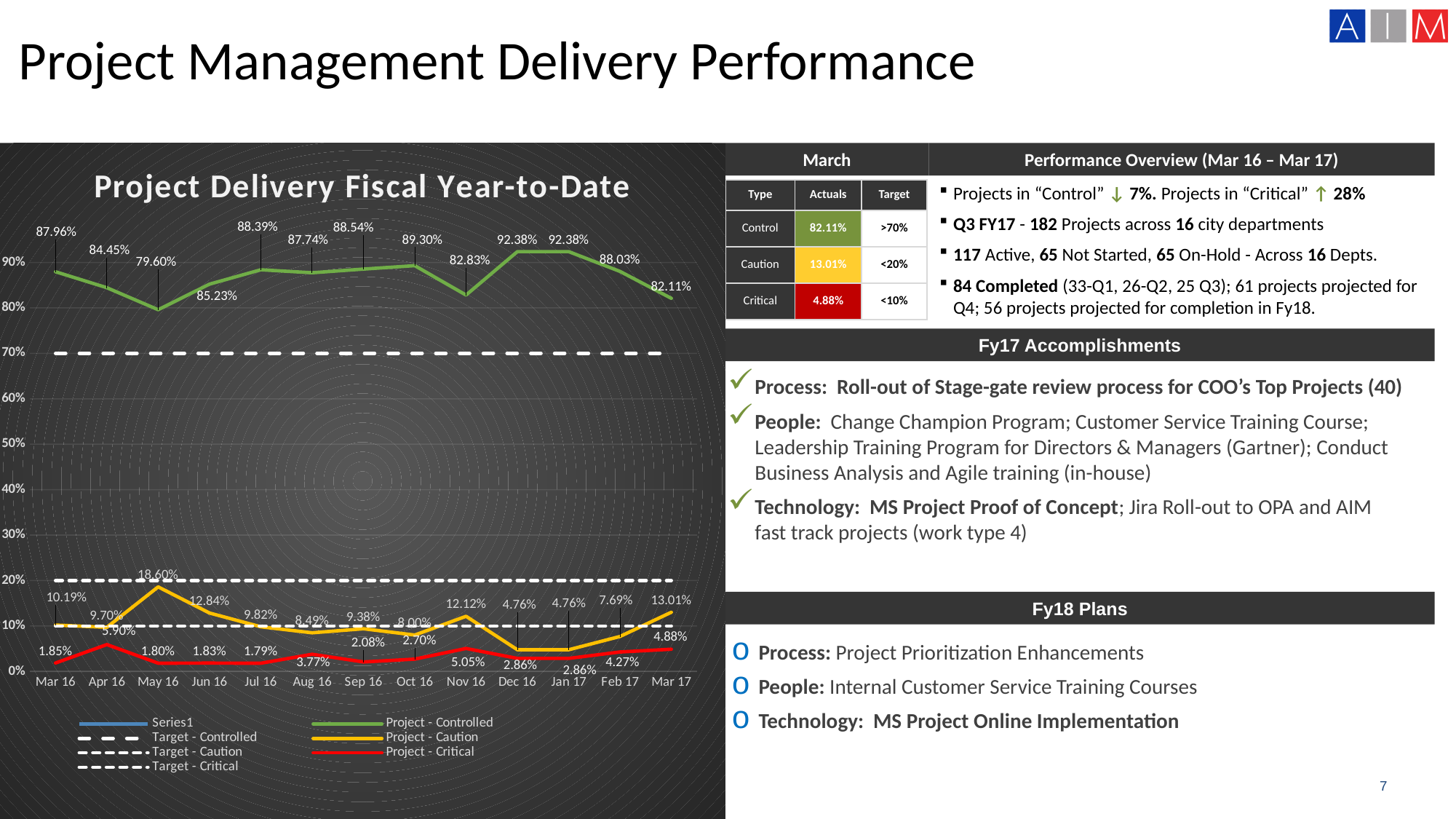
What is the value of Project - Caution in May 16? 18.60% Does Project - Caution rise or fall from May 16 to Aug 16? Fall Which is larger for Project - Critical: the value in Apr 16 or the value in Nov 16? Apr 16 In which month is Project - Critical at its highest? Apr 16 What is the value of Project - Critical in Jul 16? 1.79% How many months are plotted along the x axis? 13 What is the value of Project - Controlled in Mar 17? 82.11% In which month is Project - Controlled at its lowest? May 16 What kind of chart is shown on the slide? Line chart By how many percentage points does Project - Controlled fall from Dec 16 to Mar 17? 10.27 percentage points How many series does the legend list? 7 In which month does Project - Caution reach its highest value? May 16